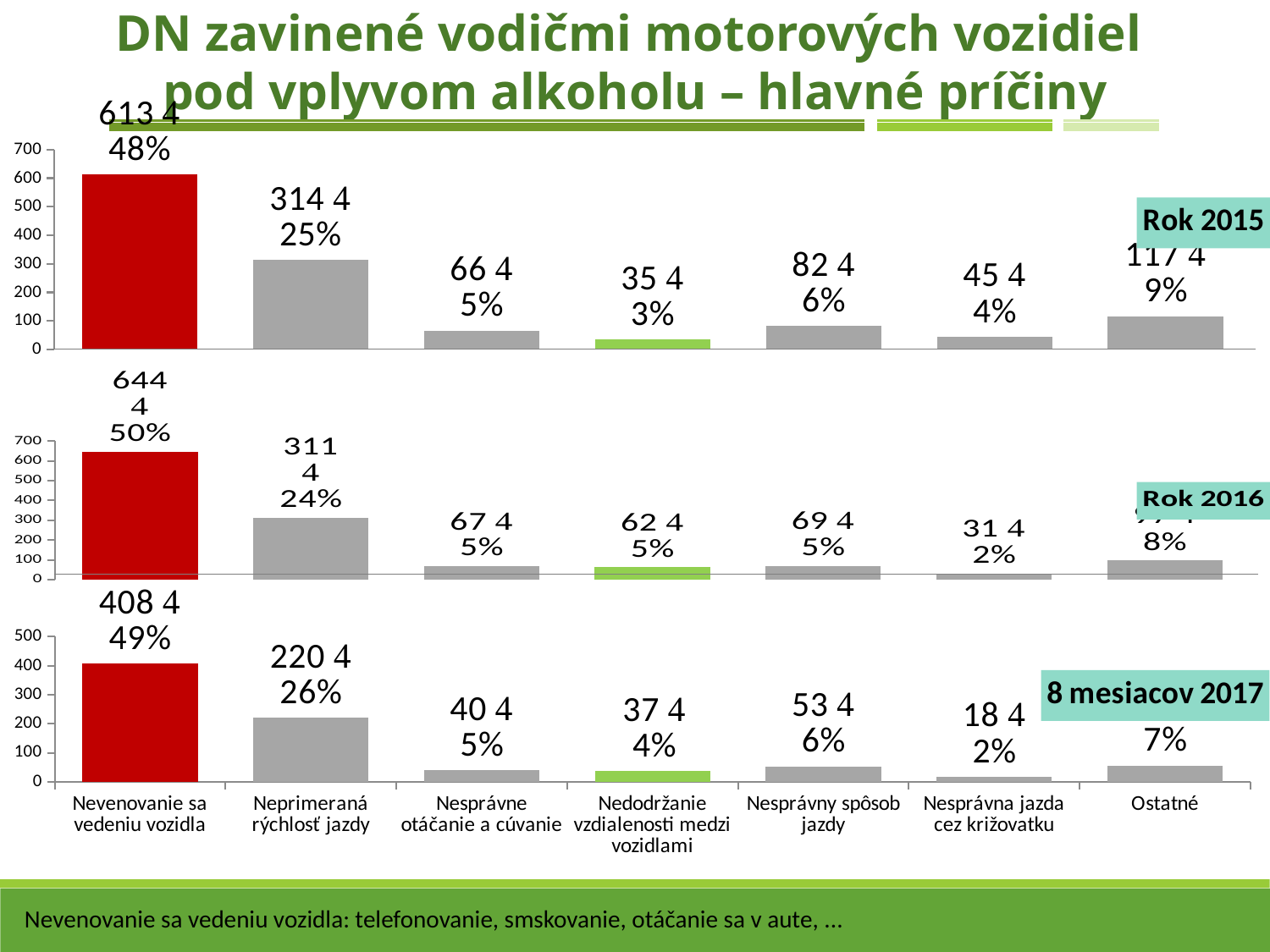
In the Rok 2015 chart, what is the difference in percentage points between Nevenovanie sa vedeniu vozidla (48%) and Neprimeraná rýchlosť jazdy (25%)? 23 percentage points In the Rok 2015 chart, which is larger: Nesprávny spôsob jazdy or Nesprávne otáčanie a cúvanie? Nesprávny spôsob jazdy In the 8 mesiacov 2017 chart, is the value for Nevenovanie sa vedeniu vozidla greater or less than 300? greater In the Rok 2016 chart, which category has the highest bar? Nevenovanie sa vedeniu vozidla In the Rok 2015 chart, what percentage is shown for Nevenovanie sa vedeniu vozidla? 48% In the Rok 2016 chart, what percentage is shown for Neprimeraná rýchlosť jazdy? 24% In the 8 mesiacov 2017 chart, which category has the lowest bar? Nesprávna jazda cez križovatku In the 8 mesiacov 2017 chart, what percentage is shown for Nesprávny spôsob jazdy? 6% Which bar is coloured red in each of the three charts? Nevenovanie sa vedeniu vozidla What kind of chart is the Rok 2015 chart? bar chart How many categories are shown along the x axis of the 8 mesiacov 2017 chart? 7 In the Rok 2015 chart, which category has the lowest bar? Nedodržanie vzdialenosti medzi vozidlami